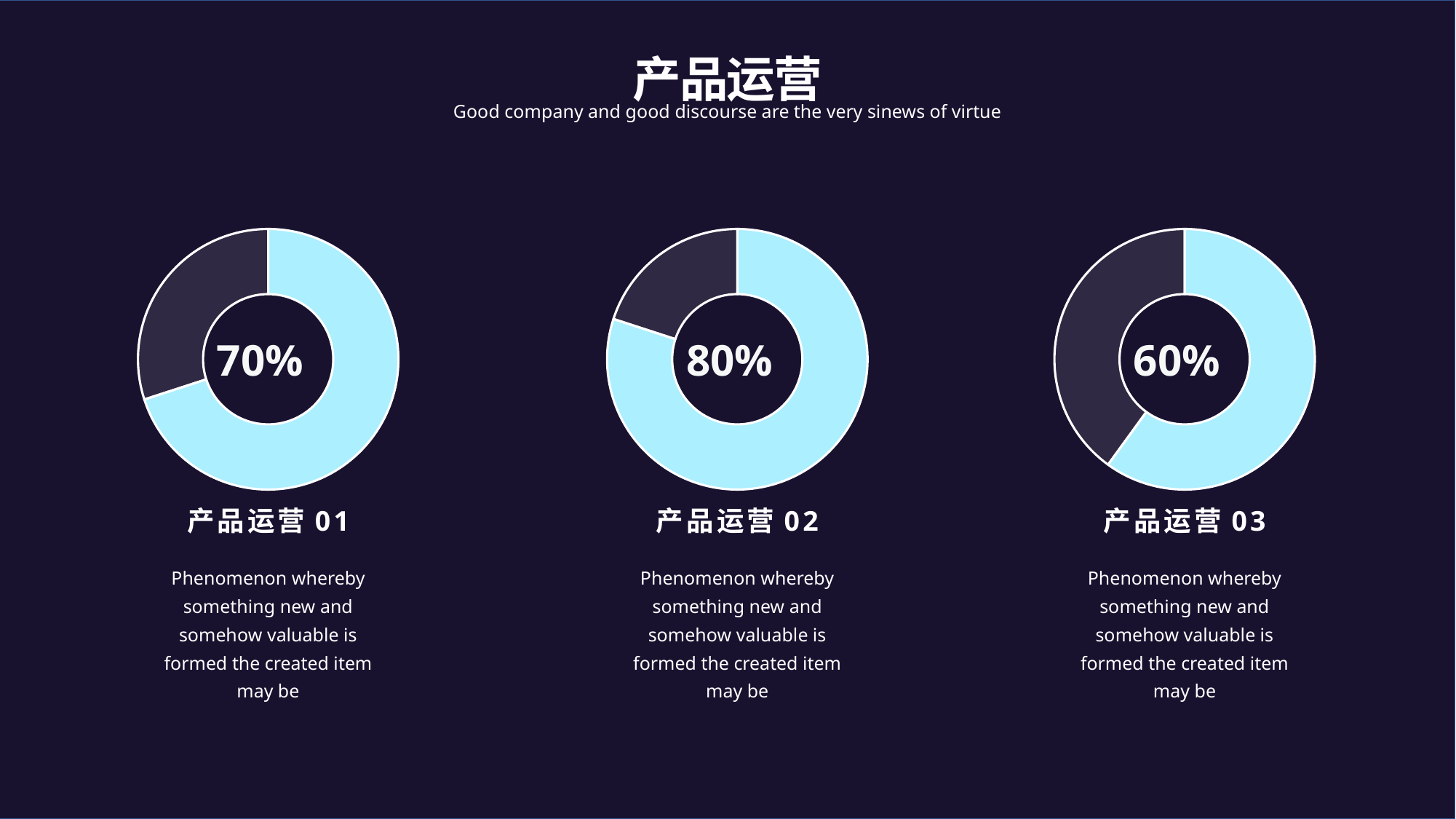
Which of the three charts shows the highest percentage? 产品运营 02 In the 产品运营 02 chart, what colour is the larger slice? light blue What is the difference between the percentage in the 产品运营 02 chart and the percentage in the 产品运营 03 chart? 20% What is the difference between the percentage in the 产品运营 02 chart and the percentage in the 产品运营 01 chart? 10% What kind of chart is used for 产品运营 01, 02 and 03? pie chart (donut) Which shows a larger percentage, the 产品运营 01 chart or the 产品运营 03 chart? 产品运营 01 How many slices does the 产品运营 01 chart have? 2 In the 产品运营 03 chart, what percentage is shown in the centre? 60% In the 产品运营 02 chart, what percentage is shown in the centre? 80% Which of the three charts shows the lowest percentage? 产品运营 03 In the 产品运营 01 chart, what percentage is shown in the centre? 70% How many donut charts are on the slide? 3